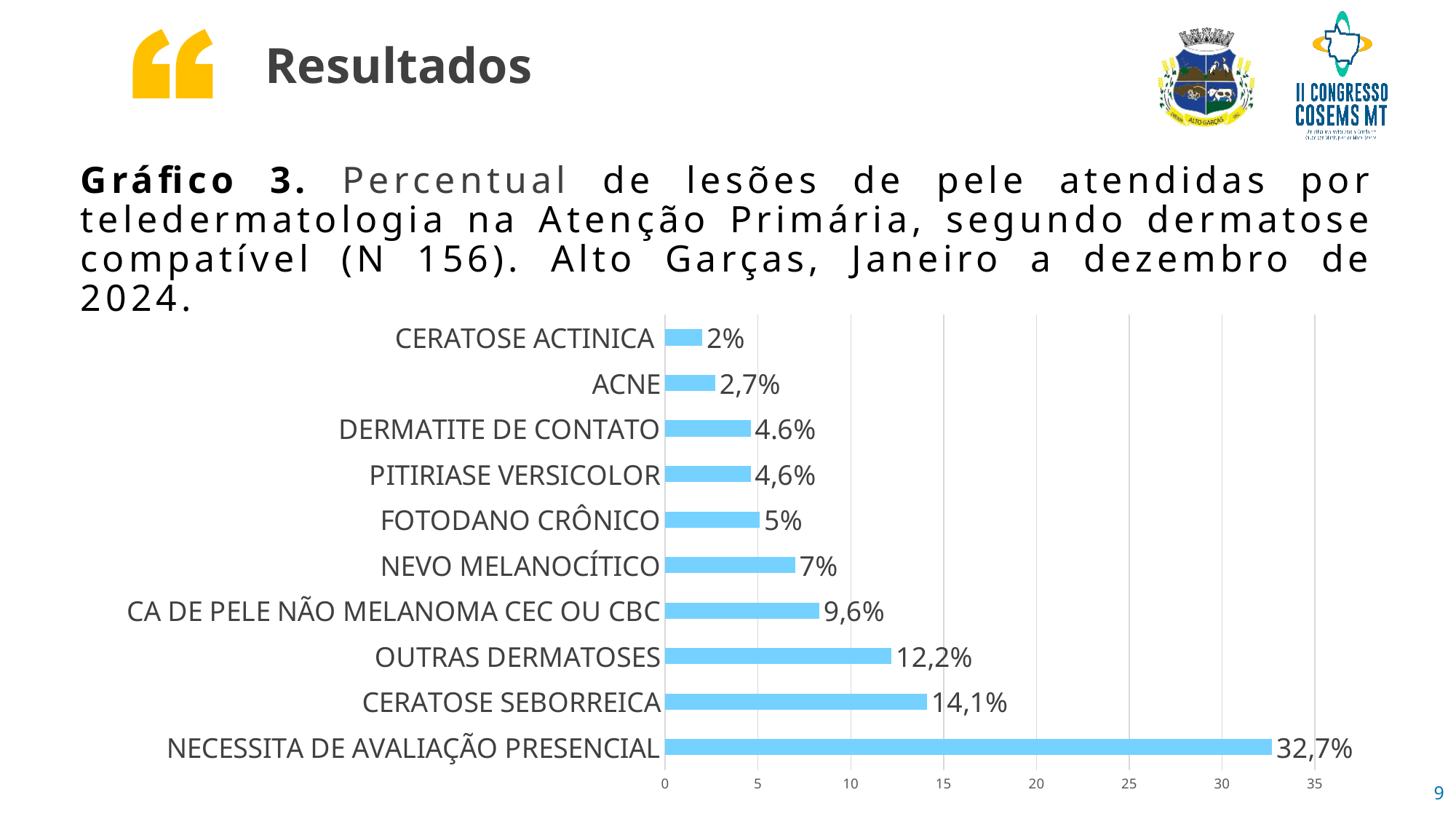
How many categories (dermatoses) are plotted in the chart? 10 Which category has the highest value? NECESSITA DE AVALIAÇÃO PRESENCIAL What is the value for NECESSITA DE AVALIAÇÃO PRESENCIAL? 32,7% What is the value for ACNE? 2,7% Which category has the lowest value? CERATOSE ACTINICA Is the value for NECESSITA DE AVALIAÇÃO PRESENCIAL greater or less than 30? greater What is the value for CERATOSE SEBORREICA? 14,1% What is the difference between NECESSITA DE AVALIAÇÃO PRESENCIAL and CERATOSE SEBORREICA? 18,6% What is the highest tick value shown on the horizontal axis? 35 Which is larger, OUTRAS DERMATOSES or NEVO MELANOCÍTICO? OUTRAS DERMATOSES What is the value for CA DE PELE NÃO MELANOMA CEC OU CBC? 9,6% What kind of chart is shown on the slide? bar chart